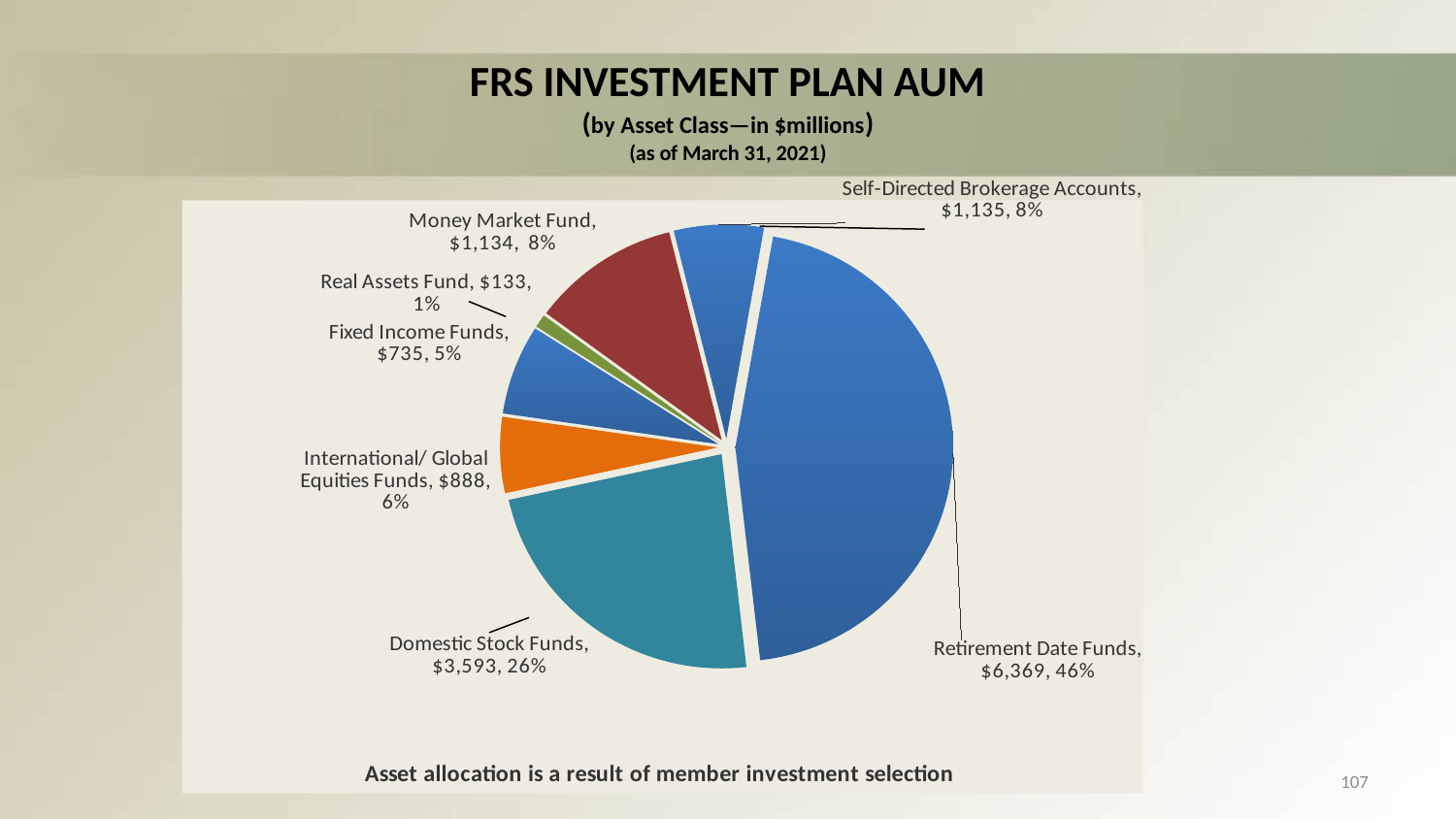
What is the AUM value for Fixed Income Funds? $735 What is the difference in AUM between Retirement Date Funds and Domestic Stock Funds? $2,776 Which asset class has the smallest share of the pie? Real Assets Fund Which asset class has the largest share of the pie? Retirement Date Funds What percentage share of the pie do International/ Global Equities Funds represent? 6% What is the AUM value for the Real Assets Fund? $133 What is the AUM value for Domestic Stock Funds? $3,593 What type of chart is shown on the slide? pie chart Which is larger, the AUM for International/ Global Equities Funds or for Fixed Income Funds? International/ Global Equities Funds How many asset classes are shown in the pie chart? 7 What percentage share of the pie do Domestic Stock Funds represent? 26% What is the AUM value for Retirement Date Funds? $6,369